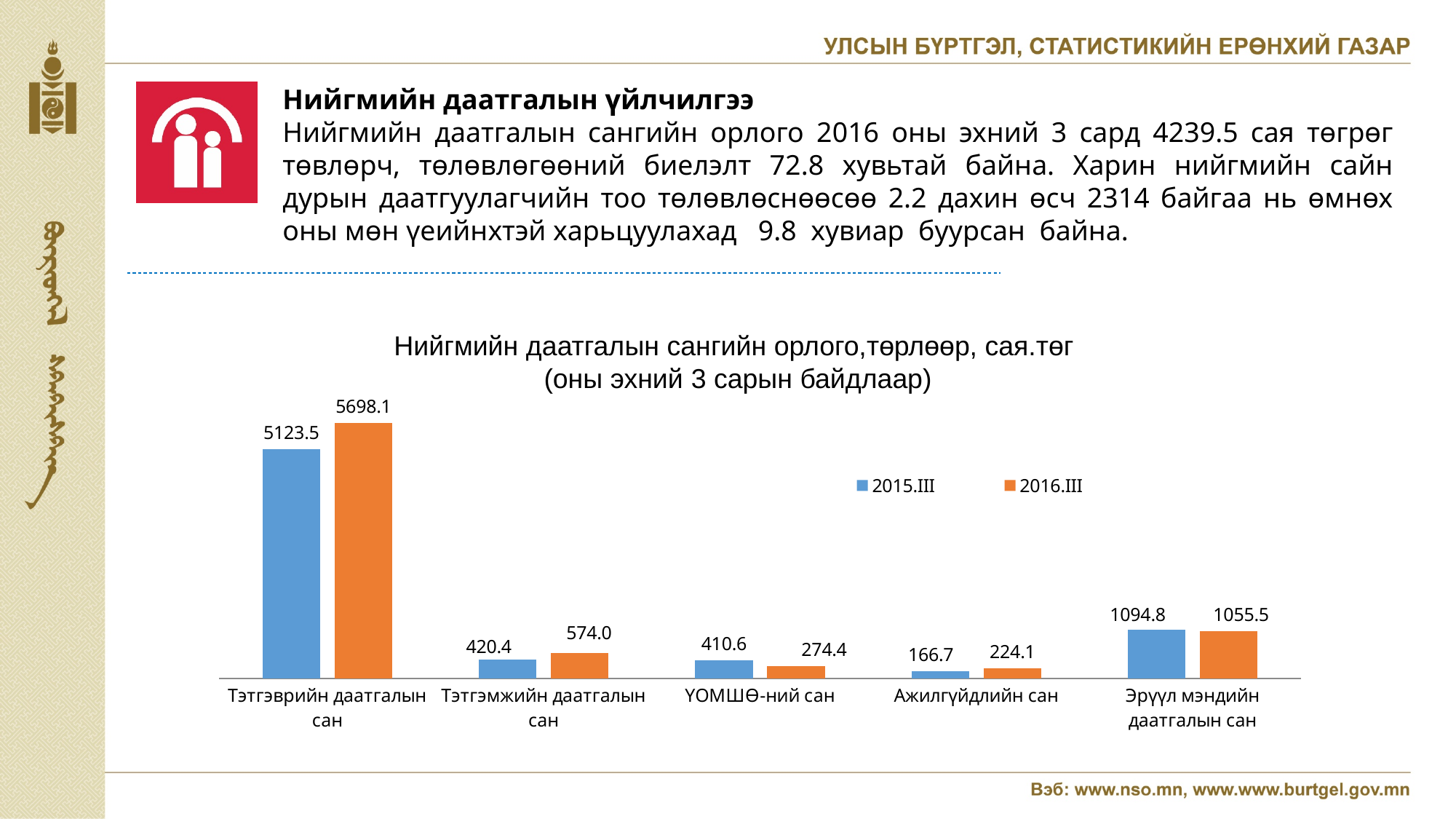
What is the value for Тэтгэврийн даатгалын сан in the 2016.III series? 5698.1 What is the value for Ажилгүйдлийн сан in the 2016.III series? 224.1 Which category has the highest value in the 2016.III series? Тэтгэврийн даатгалын сан What type of chart is shown on the slide? Bar chart What is the difference between the 2016.III and 2015.III values for Тэтгэврийн даатгалын сан? 574.6 How many categories are shown on the x axis of the chart? 5 What is the value for ҮОМШӨ-ний сан in the 2015.III series? 410.6 What is the value for Эрүүл мэндийн даатгалын сан in the 2015.III series? 1094.8 Which category has the lowest value in the 2015.III series? Ажилгүйдлийн сан What is the difference between the 2015.III and 2016.III values for ҮОМШӨ-ний сан? 136.2 How many series does the chart legend list? 2 For Тэтгэмжийн даатгалын сан, which series has the larger value, 2015.III or 2016.III? 2016.III